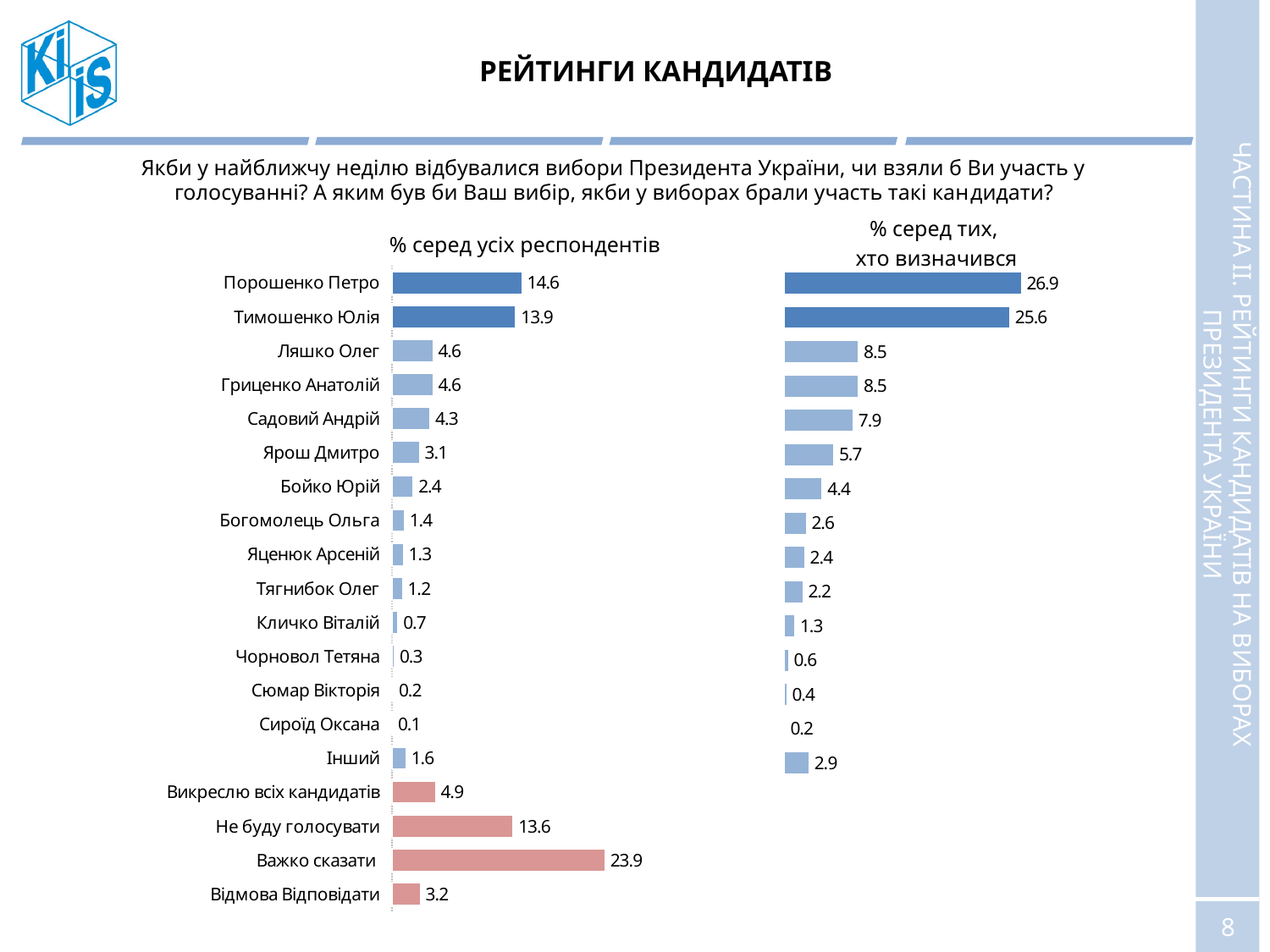
In the chart titled "% серед тих, хто визначився", which category has the lowest value? Сироїд Оксана In the chart titled "% серед тих, хто визначився", which category has the highest value? Порошенко Петро How many categories are shown in the chart titled "% серед тих, хто визначився"? 15 How many categories are shown in the chart titled "% серед усіх респондентів"? 19 In the chart titled "% серед тих, хто визначився", what is the difference between the values for Порошенко Петро and Тимошенко Юлія? 1.3 In the chart titled "% серед тих, хто визначився", what is the value for Тимошенко Юлія? 25.6 In the chart titled "% серед усіх респондентів", what is the value for Не буду голосувати? 13.6 In the chart titled "% серед усіх респондентів", what is the value for Порошенко Петро? 14.6 In the chart titled "% серед усіх респондентів", which category has the highest value? Важко сказати In the chart titled "% серед усіх респондентів", what is the difference between the values for Порошенко Петро and Тимошенко Юлія? 0.7 What kind of chart is the chart titled "% серед усіх респондентів"? Bar chart In the chart titled "% серед усіх респондентів", which is larger: the value for Ляшко Олег or for Садовий Андрій? Ляшко Олег